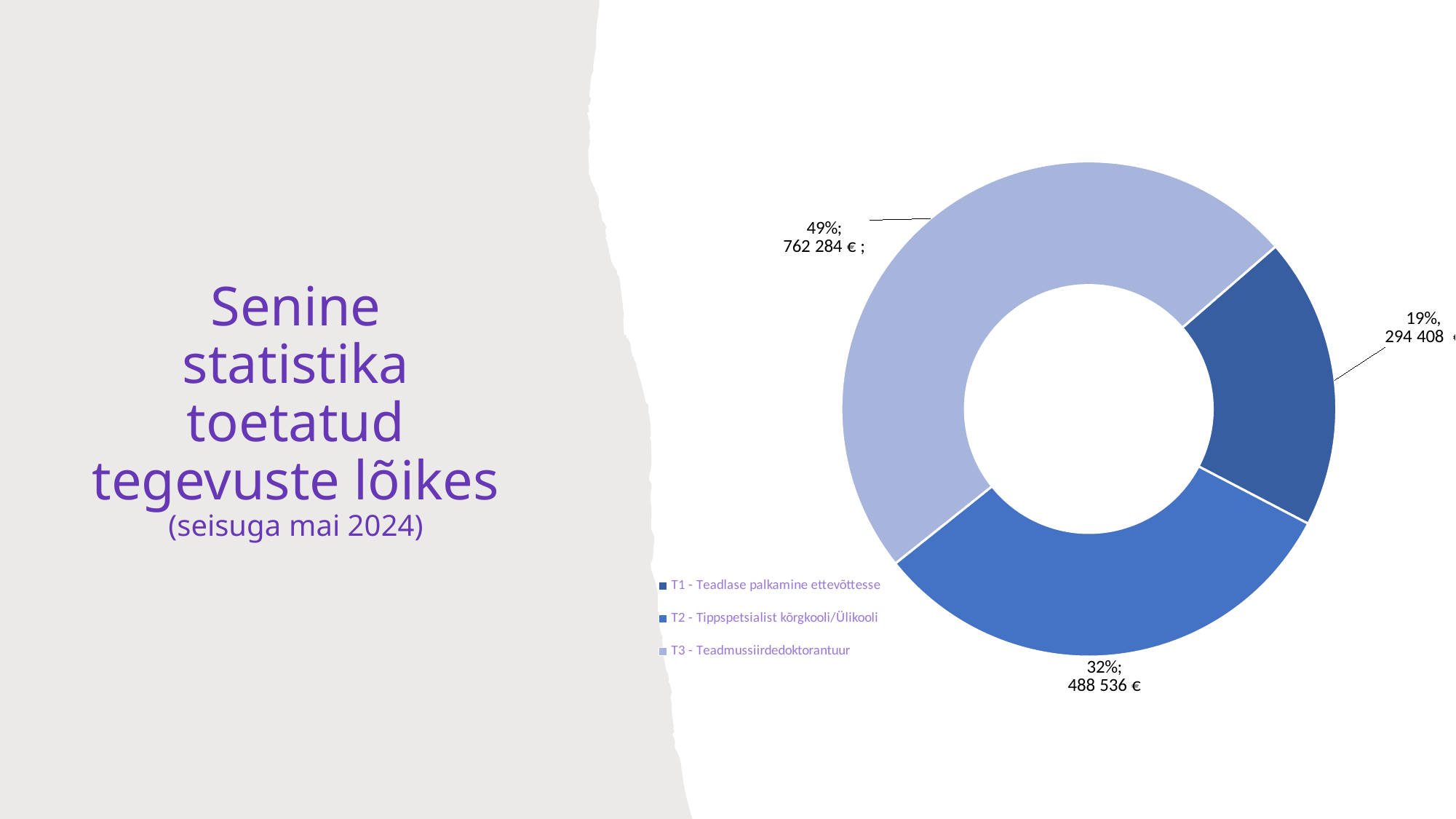
Which category has the largest slice in the doughnut chart? T3 - Teadmussiirdedoktorantuur What kind of chart is shown on the slide? doughnut chart Which slice is larger, T2 - Tippspetsialist kõrgkooli/Ülikooli or T1 - Teadlase palkamine ettevõttesse? T2 - Tippspetsialist kõrgkooli/Ülikooli What share of the doughnut chart does T3 - Teadmussiirdedoktorantuur represent? 49% How many categories does the legend of the chart list? 3 What share of the doughnut chart does T1 - Teadlase palkamine ettevõttesse represent? 19% What is the title of the slide containing the chart? Senine statistika toetatud tegevuste lõikes (seisuga mai 2024) What is the difference in amount between T3 - Teadmussiirdedoktorantuur and T2 - Tippspetsialist kõrgkooli/Ülikooli? 273 748 € What is the amount shown for T2 - Tippspetsialist kõrgkooli/Ülikooli? 488 536 € What share of the doughnut chart does T2 - Tippspetsialist kõrgkooli/Ülikooli represent? 32% Which category has the smallest slice in the doughnut chart? T1 - Teadlase palkamine ettevõttesse What is the amount shown for T3 - Teadmussiirdedoktorantuur? 762 284 €